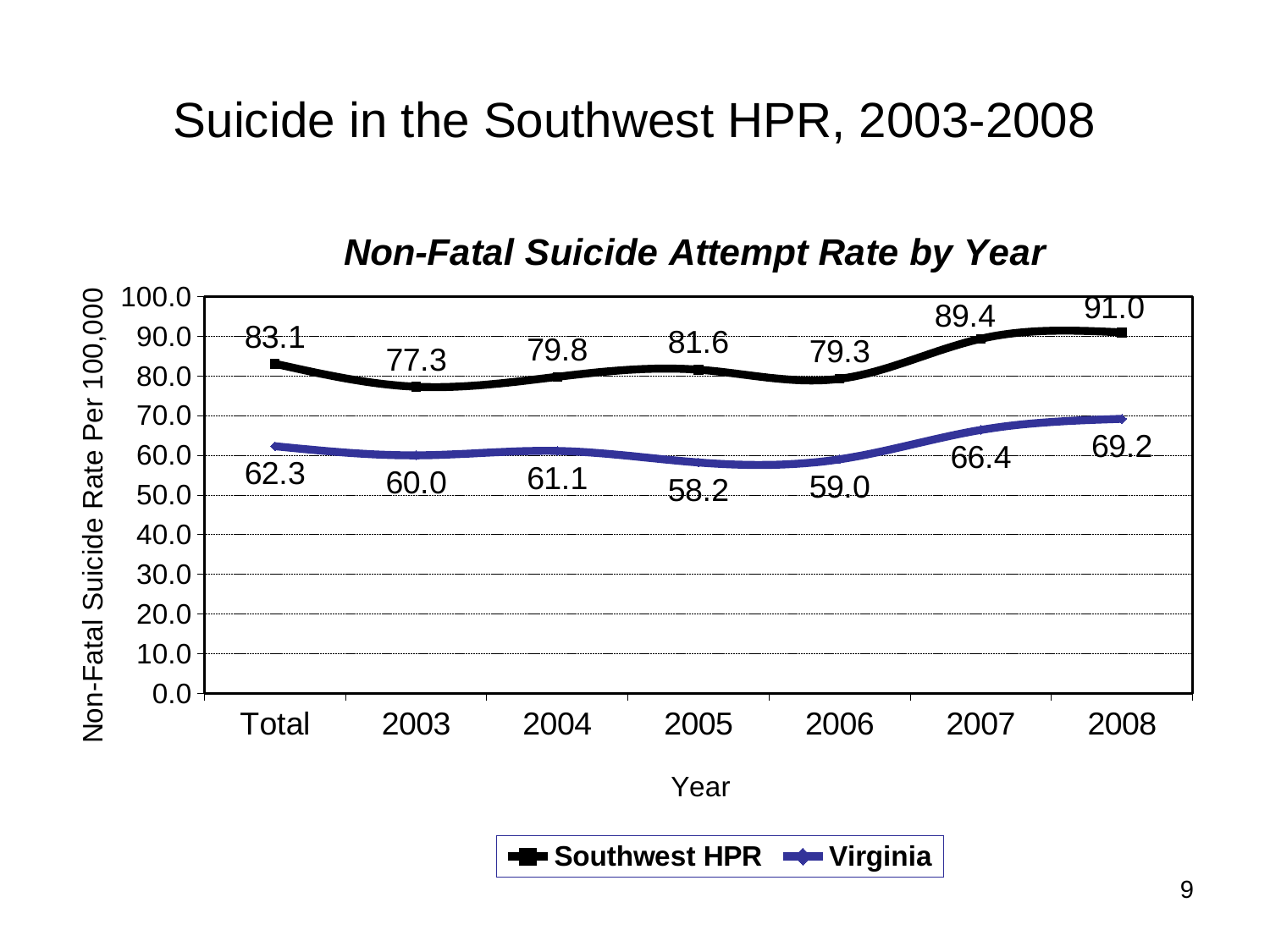
What is the Virginia non-fatal suicide attempt rate for 2005? 58.2 What is the Southwest HPR non-fatal suicide attempt rate for 2008? 91.0 How many series does the legend list? 2 What kind of chart is shown on the slide? line chart What is the difference between the Southwest HPR and Virginia rates in 2007? 23.0 How many categories are shown on the x axis? 7 What is the Southwest HPR rate for the Total category? 83.1 In which year is the Virginia rate lowest? 2005 What is the title of the chart? Non-Fatal Suicide Attempt Rate by Year Does the Virginia rate rise or fall from 2006 to 2008? rise Which is larger, the Southwest HPR rate in 2003 or the Southwest HPR rate in 2006? 2006 In which year is the Southwest HPR rate highest? 2008